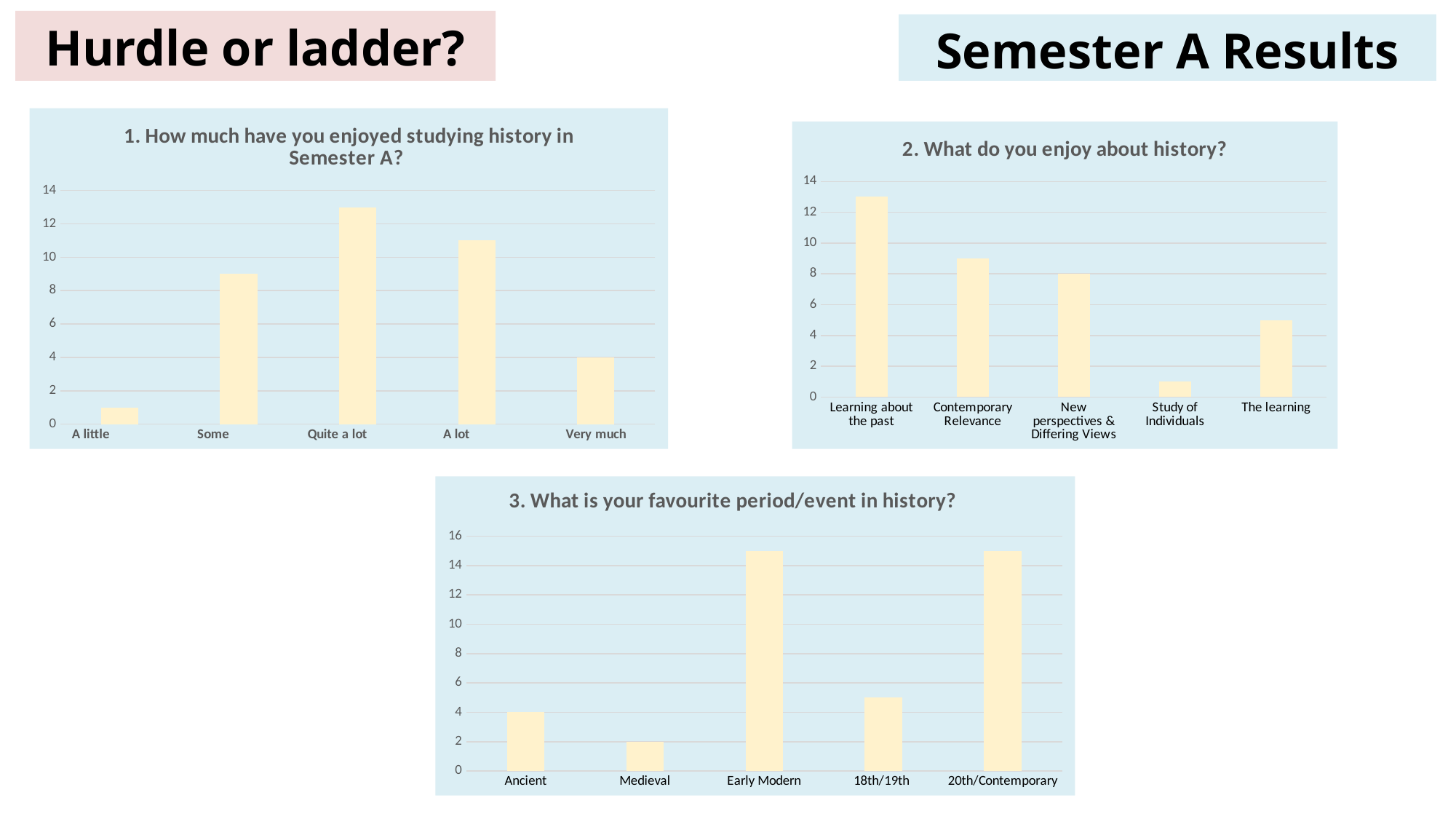
In the chart titled '1. How much have you enjoyed studying history in Semester A?', how many categories are shown on the x axis? 5 In the chart titled '1. How much have you enjoyed studying history in Semester A?', which category has the highest value? Quite a lot In the chart titled '2. What do you enjoy about history?', which category has the highest value? Learning about the past In the chart titled '2. What do you enjoy about history?', what is the value for 'New perspectives & Differing Views'? 8 In the chart titled '1. How much have you enjoyed studying history in Semester A?', is the value for 'Some' greater or less than 8? greater In the chart titled '1. How much have you enjoyed studying history in Semester A?', which category has the lowest value? A little In the chart titled '2. What do you enjoy about history?', which category has the lowest value? Study of Individuals In the chart titled '2. What do you enjoy about history?', is the value for 'Contemporary Relevance' greater or less than 10? less What kind of chart is the chart titled '3. What is your favourite period/event in history?'? bar chart In the chart titled '3. What is your favourite period/event in history?', what is the value for 'Ancient'? 4 In the chart titled '1. How much have you enjoyed studying history in Semester A?', what is the value for 'Very much'? 4 In the chart titled '3. What is your favourite period/event in history?', which category has the lowest value? Medieval